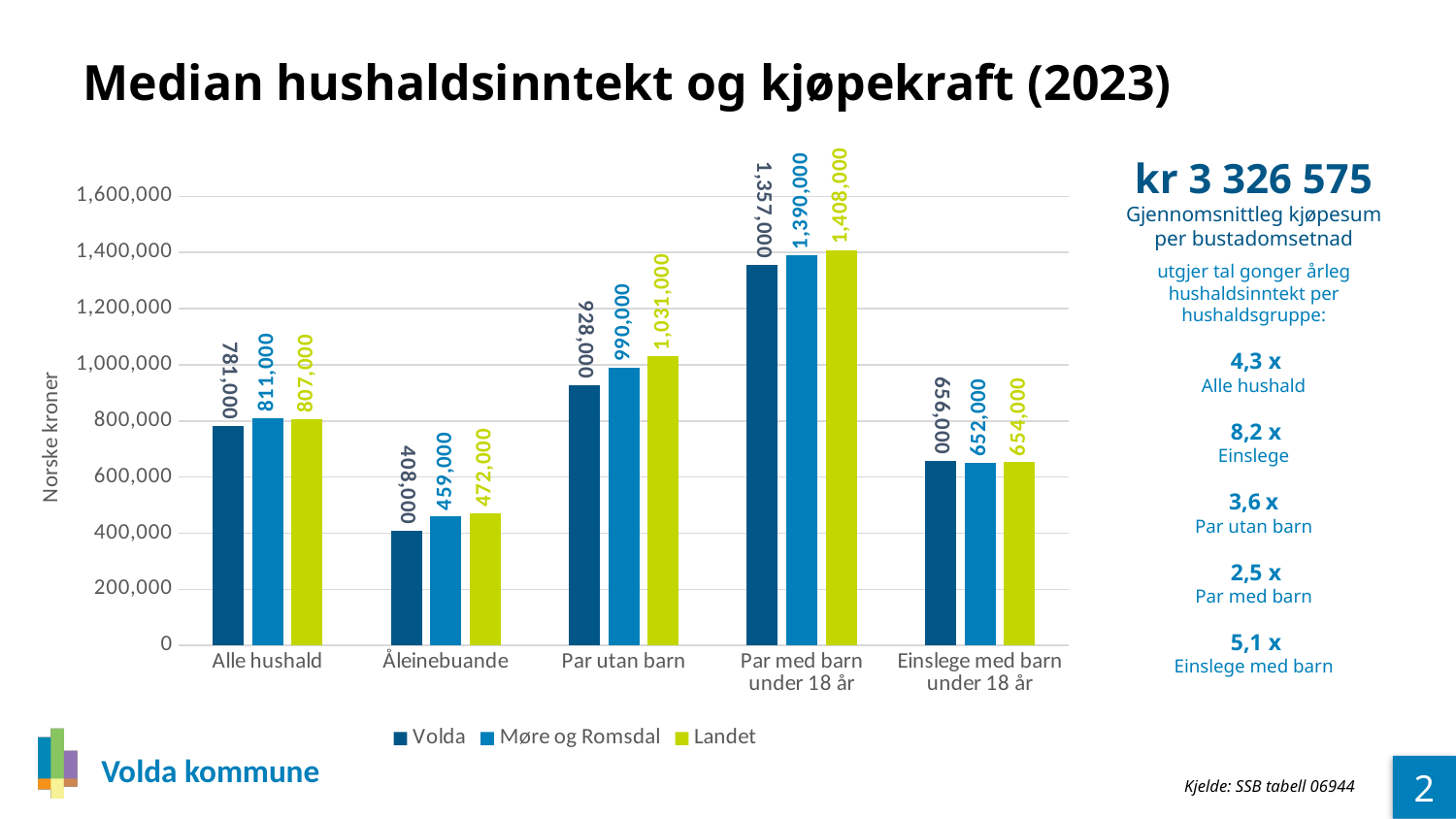
How many categories are shown on the x axis? 5 What kind of chart is shown on the slide? Bar chart Which category has the lowest value for Volda? Åleinebuande How many series does the legend list? 3 In the Åleinebuande category, which is larger: the value for Volda or the value for Landet? Landet What is the value for Møre og Romsdal in the Åleinebuande category? 459,000 What is the difference between the Landet and Volda values in the Par utan barn category? 103,000 What is the value for Volda in the Alle hushald category? 781,000 Which category has the highest value for Landet? Par med barn under 18 år What is the value for Landet in the Par utan barn category? 1,031,000 What is the label of the y axis? Norske kroner What is the value for Volda in the Par med barn under 18 år category? 1,357,000